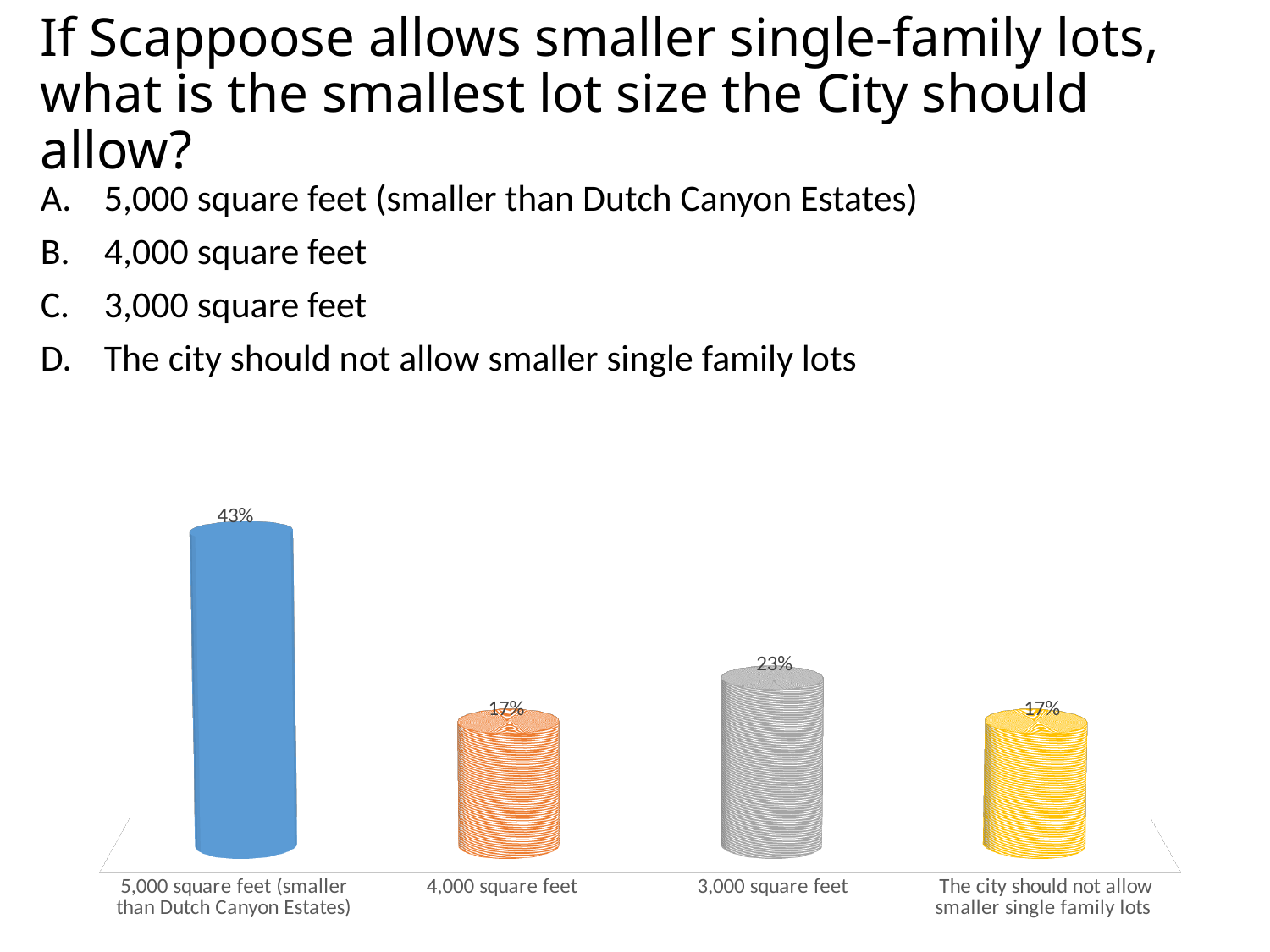
What kind of chart is shown on the slide? Bar chart What percentage of respondents chose 4,000 square feet? 17% What colour is the bar for the 5,000 square feet option? Blue What is the difference in percentage points between the 5,000 square feet option and the 3,000 square feet option? 20 What percentage of respondents chose 5,000 square feet (smaller than Dutch Canyon Estates)? 43% Which option received the highest percentage of responses? 5,000 square feet (smaller than Dutch Canyon Estates) Which two options received the same percentage of responses? 4,000 square feet and The city should not allow smaller single family lots What is the difference in percentage points between the 3,000 square feet option and the 4,000 square feet option? 6 What percentage of respondents chose 3,000 square feet? 23% Which received a larger share of responses: 3,000 square feet or 4,000 square feet? 3,000 square feet What percentage of respondents chose 'The city should not allow smaller single family lots'? 17% How many response options are shown in the chart? 4